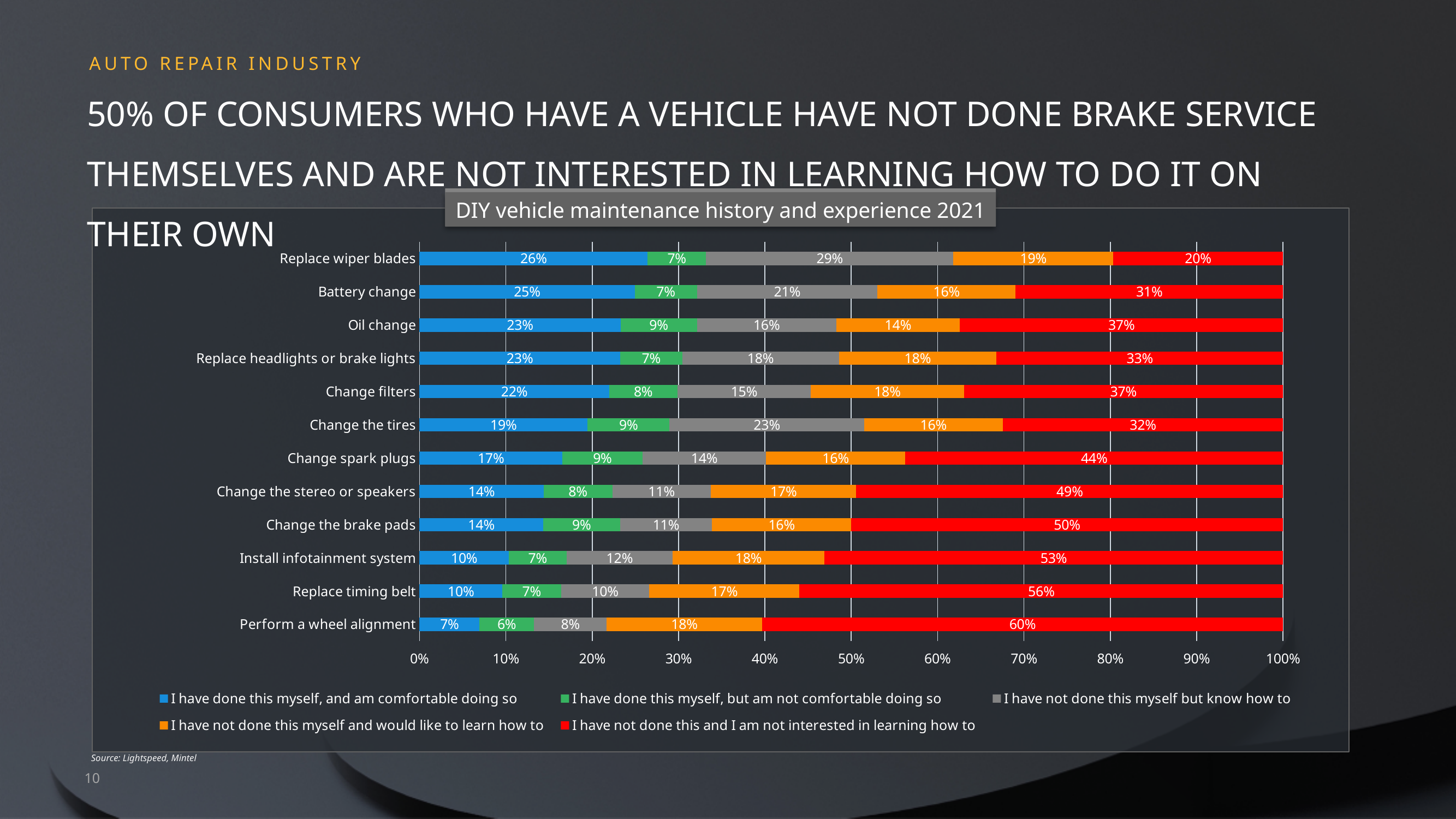
What percentage of consumers have not done a wheel alignment and are not interested in learning how to? 60% Which has a larger share of consumers not interested in learning how to do it: Oil change or Battery change? Oil change How many maintenance tasks are listed in the chart? 12 What is the title of the chart? DIY vehicle maintenance history and experience 2021 What kind of chart is shown on the slide? Stacked bar chart What percentage of consumers say they have done replacing wiper blades themselves and are comfortable doing so? 26% For Oil change, what percentage have not done this themselves but know how to? 16% Which task has the lowest share of consumers who have done it themselves and are comfortable doing so? Perform a wheel alignment What is the difference in percentage points between the 'not interested in learning' share for Change spark plugs and for Change the tires? 12 percentage points Which task has the highest share of consumers who have not done it and are not interested in learning how to? Perform a wheel alignment Is the 'not interested in learning' value for Change the brake pads greater or less than 40%? greater How many series does the legend list? 5